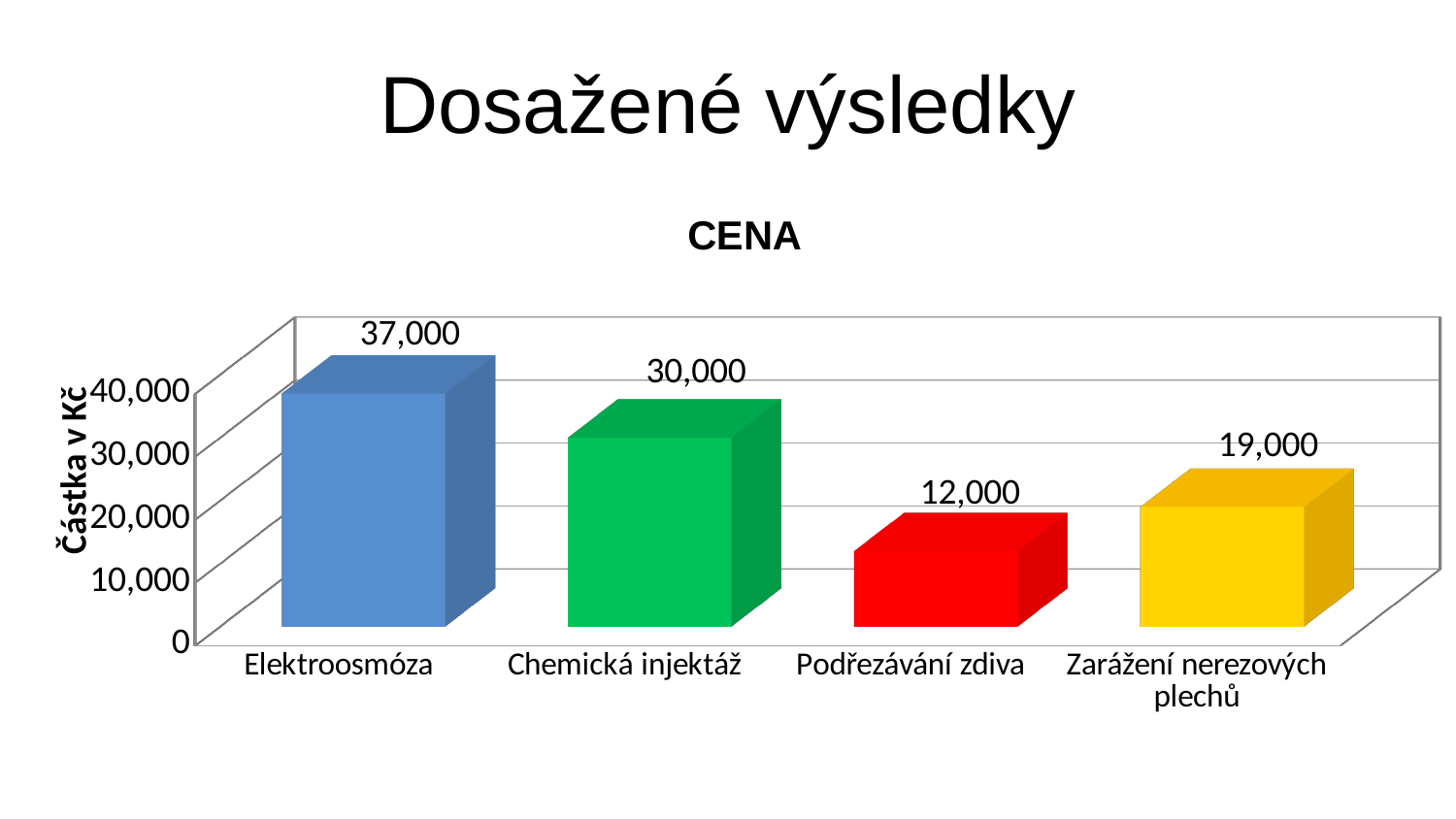
How many categories are shown in the chart? 4 What kind of chart is shown on the slide? bar chart Which is larger, the value for Chemická injektáž or the value for Zarážení nerezových plechů? Chemická injektáž What is the difference between the values for Zarážení nerezových plechů and Podřezávání zdiva? 7,000 What is the difference between the values for Elektroosmóza and Chemická injektáž? 7,000 What is the value for Chemická injektáž? 30,000 Which category has the lowest value? Podřezávání zdiva What is the value for Podřezávání zdiva? 12,000 Which category has the highest value? Elektroosmóza What is the title of the chart? CENA What is the value for Zarážení nerezových plechů? 19,000 What is the value for Elektroosmóza? 37,000